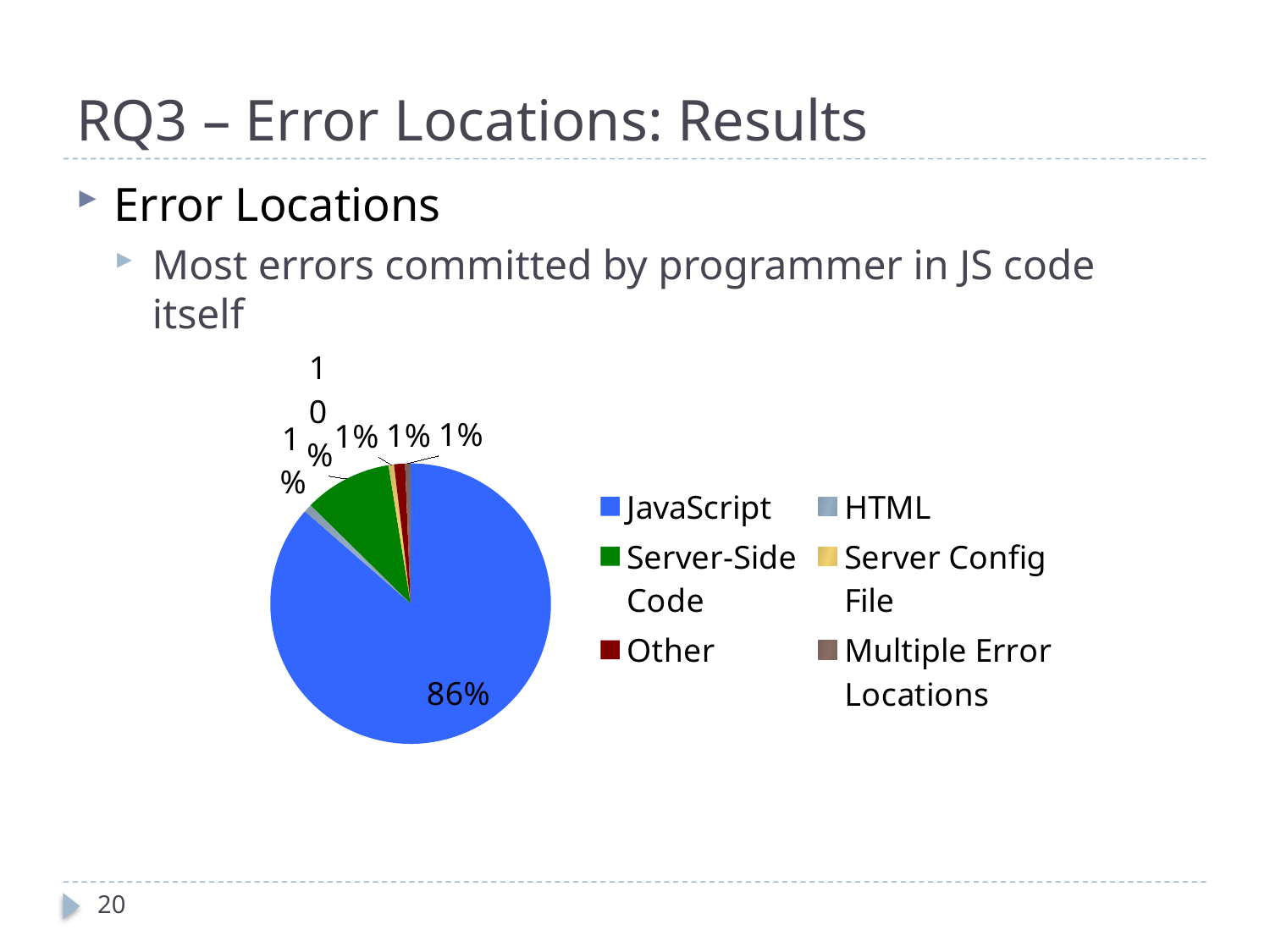
Which legend entry is shown in green? Server-Side Code How many categories does the legend of the pie chart list? 6 What is the value shown for the Multiple Error Locations slice? 1% Which is larger, the slice for JavaScript or the slice for Server-Side Code? JavaScript What kind of chart is shown on the slide? pie chart What colour is the JavaScript slice in the pie chart? blue What is the value shown for the Server Config File slice? 1% What share of the pie does JavaScript account for? 86% What is the value shown for the Other slice? 1% Which is larger, the slice for Server-Side Code or the slice for HTML? Server-Side Code Which error location has the largest slice of the pie? JavaScript